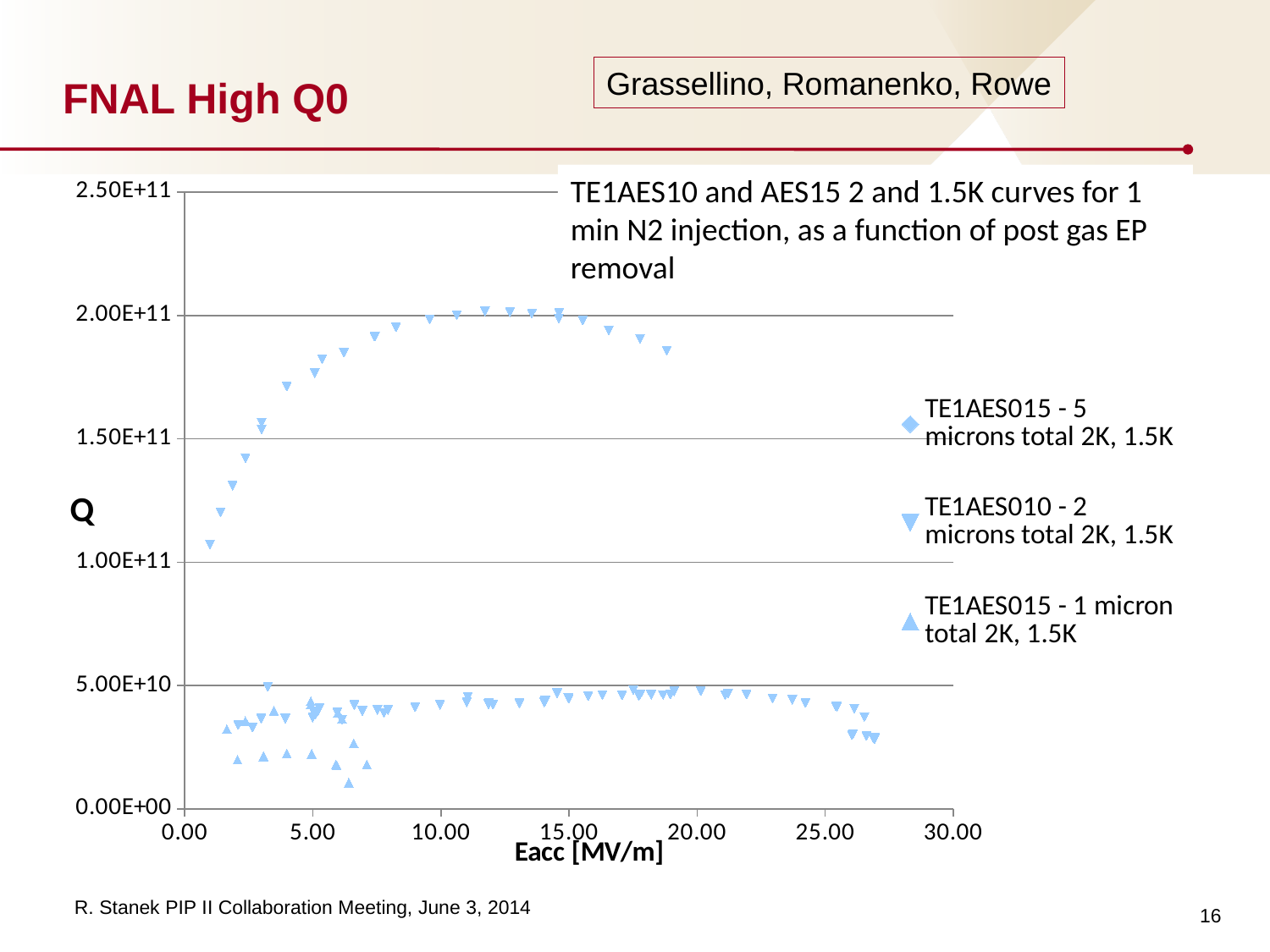
What is the label of the chart's x axis? Eacc [MV/m] Along the x axis from 0.00 to about 10.00, does the upper curve on the chart rise or fall? rise Are the Q values of the lower cluster of points on the chart greater or less than 1.00E+11? less What is the highest value shown on the y axis of the chart? 2.50E+11 What is the highest value shown on the x axis of the chart? 30.00 Along the x axis from about 15.00 to 20.00, does the upper curve on the chart rise or fall? fall Is the highest plotted Q value on the chart greater or less than 1.50E+11? greater How many series does the chart legend list? 3 Is the Q value of the upper curve at Eacc = 5.00 greater or less than 1.50E+11? greater What kind of chart is shown on the slide? Scatter chart